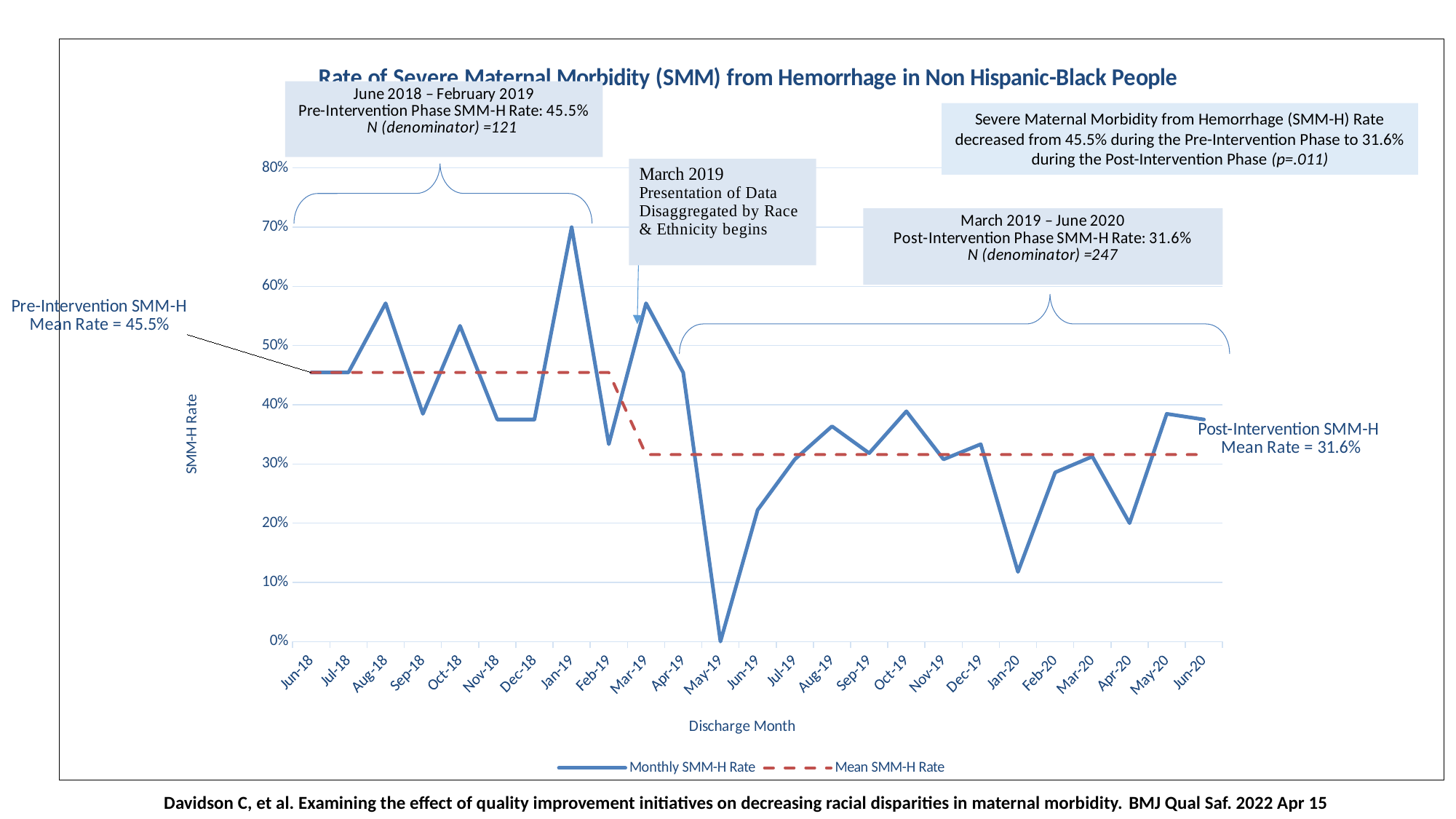
Which discharge month has the highest Monthly SMM-H Rate? Jan-19 Is the Monthly SMM-H Rate for Jan-20 greater or less than 20%? less By how many percentage points did the mean SMM-H rate decrease from the Pre-Intervention Phase to the Post-Intervention Phase? 13.9 percentage points What kind of chart is shown on the slide? Line chart How many series does the legend list? 2 Is the Monthly SMM-H Rate for Aug-18 greater or less than 50%? greater What is the title of the x axis? Discharge Month What is the Pre-Intervention SMM-H mean rate shown on the chart? 45.5% How many discharge months are plotted along the x axis? 25 Which discharge month has the lowest Monthly SMM-H Rate? May-19 What is the Post-Intervention SMM-H mean rate shown on the chart? 31.6% What is the N (denominator) for the Post-Intervention Phase? 247